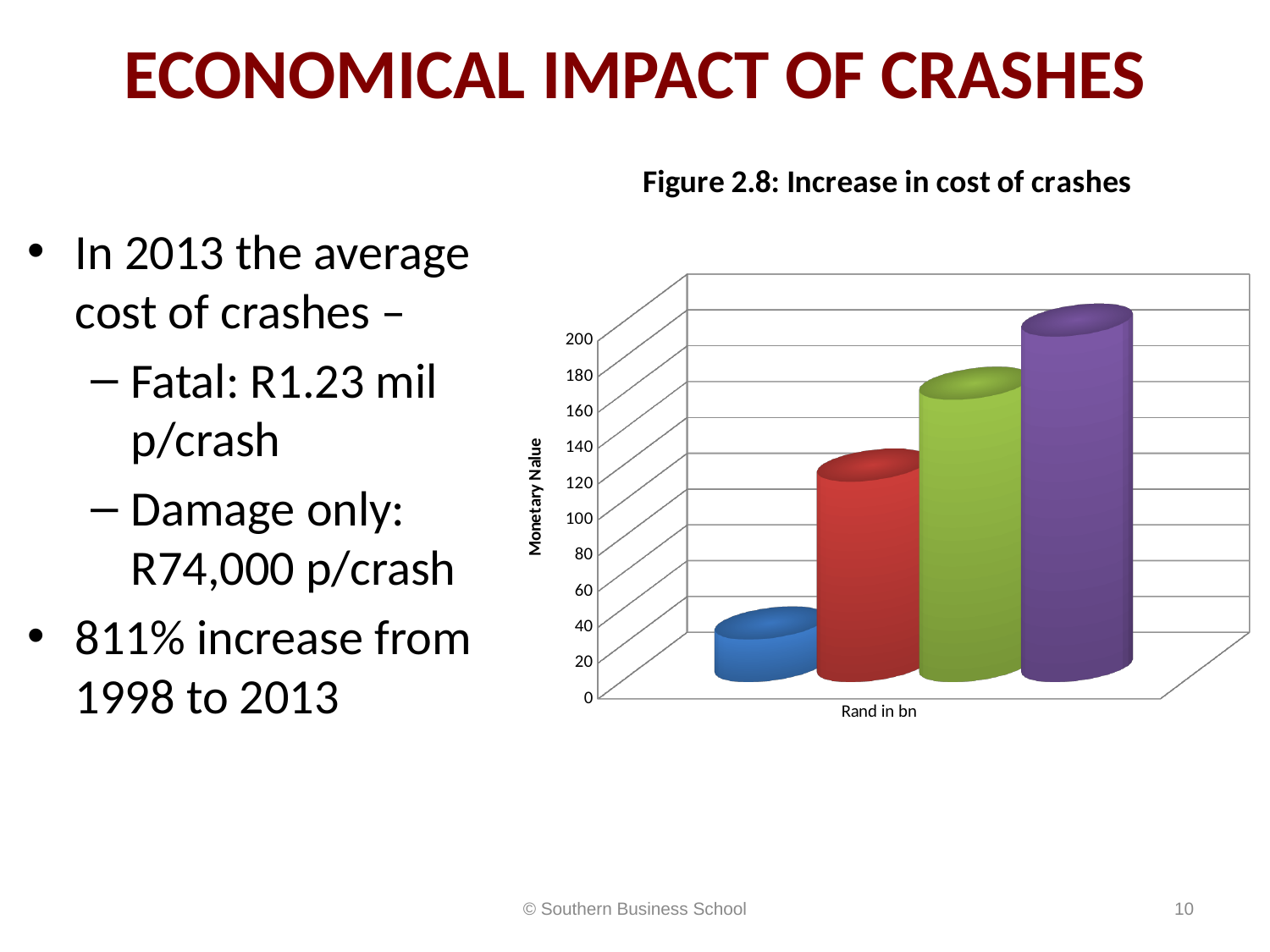
Which bar is the shortest in the chart? the blue bar Is the value of the green bar greater or less than 140? greater Do the bar values rise or fall from left to right across the chart? rise What kind of chart is shown on the slide? bar chart Is the value of the red bar greater or less than 100? greater What is the title of the chart? Figure 2.8: Increase in cost of crashes How many bars are plotted in the chart? 4 Is the value of the purple bar greater or less than 160? greater What is the label on the horizontal axis of the chart? Rand in bn Which bar is the tallest in the chart? the purple bar Which is taller, the red bar or the green bar? the green bar